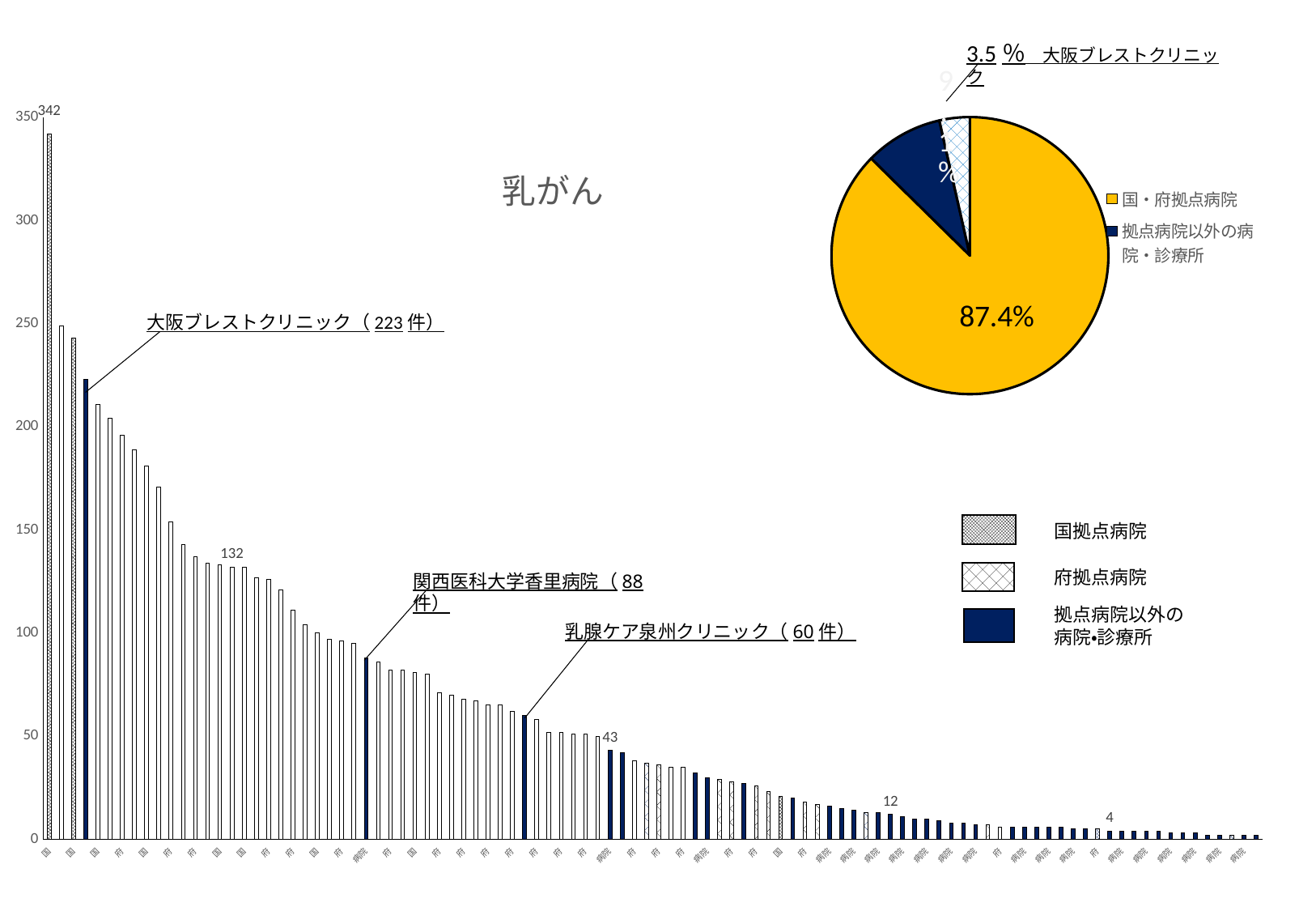
In the bar chart titled 乳がん, how many cases are shown for 大阪ブレストクリニック? 223件 In the bar chart titled 乳がん, how many cases are shown for 関西医科大学香里病院? 88件 In the pie chart, what share is shown for 大阪ブレストクリニック? 3.5% In the bar chart titled 乳がん, do the bar values rise or fall from left to right? fall In the bar chart titled 乳がん, how many series does the legend list? 3 In the bar chart titled 乳がん, what is the value of the tallest bar? 342 In the pie chart, what share is shown for 国・府拠点病院? 87.4% In the bar chart titled 乳がん, what is the difference between the cases for 大阪ブレストクリニック and 関西医科大学香里病院? 135 In the bar chart titled 乳がん, which has more cases, 関西医科大学香里病院 or 乳腺ケア泉州クリニック? 関西医科大学香里病院 In the bar chart titled 乳がん, how many cases are shown for 乳腺ケア泉州クリニック? 60件 What kind of chart is the chart titled 乳がん on the left of the slide? bar chart What kind of chart is shown in the top right of the slide? pie chart